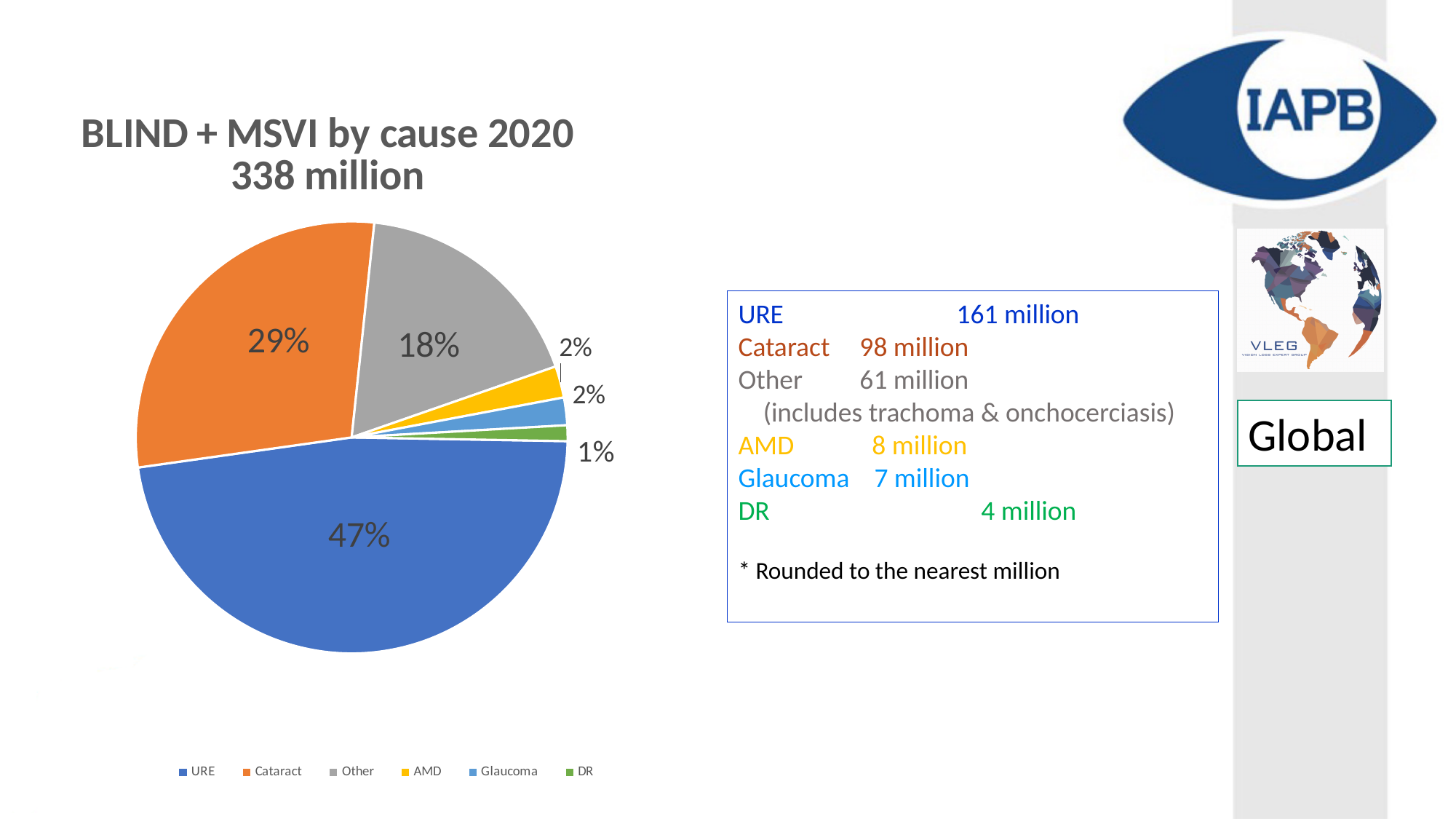
Which cause has the largest slice of the pie? URE What is the difference in percentage points between the URE slice and the Cataract slice? 18% What colour is the Cataract slice in the pie chart? orange Which cause has the smallest slice of the pie? DR What percentage is shown for DR in the pie chart? 1% Which slice is larger, Cataract or Other? Cataract What is the title of the pie chart? BLIND + MSVI by cause 2020 338 million What percentage is shown for Cataract in the pie chart? 29% What percentage is shown for Other in the pie chart? 18% How many categories does the pie chart show? 6 What share of the pie does URE account for? 47% What type of chart is shown on the slide? pie chart